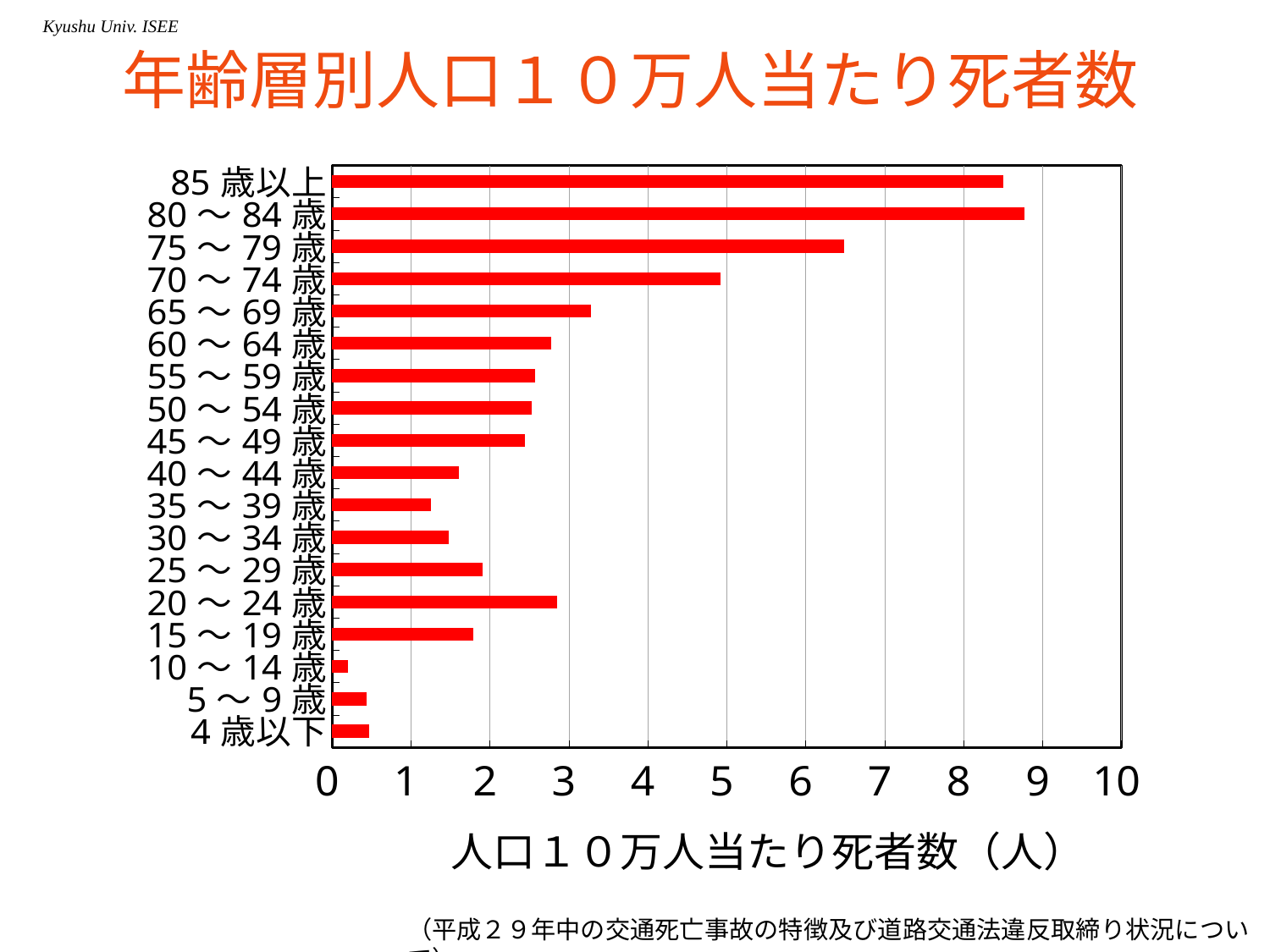
Is the value for 65～69歳 greater or less than 3? greater What kind of chart is shown on the slide? bar chart Is the value for 10～14歳 greater or less than 1? less How many age categories are plotted in the chart? 18 Which age category has the lowest number of deaths per 100,000 population? 10～14歳 What is the label of the horizontal axis? 人口１０万人当たり死者数（人） Which age category has the highest number of deaths per 100,000 population? 80～84歳 Is the value for 75～79歳 greater or less than 6? greater Which has a higher value, 75～79歳 or 70～74歳? 75～79歳 Which has a higher value, 20～24歳 or 15～19歳? 20～24歳 What is the title of the chart on the slide? 年齢層別人口１０万人当たり死者数